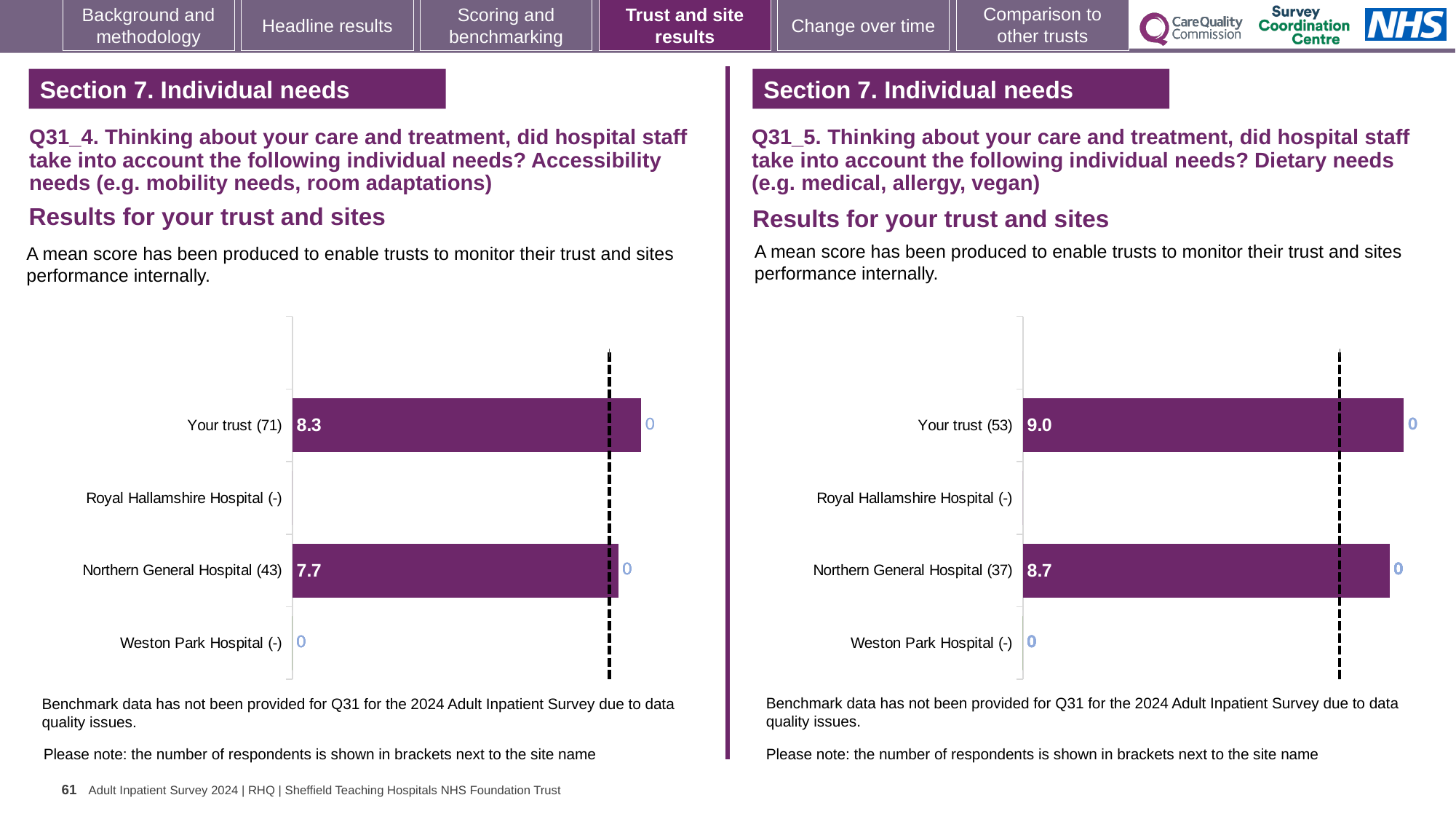
How many site categories are listed on the left chart (Q31_4, accessibility needs)? 4 On the right chart (Q31_5, dietary needs), what is the mean score for Northern General Hospital? 8.7 On the right chart (Q31_5, dietary needs), what is the difference between the mean score for Your trust and for Northern General Hospital? 0.3 On the right chart (Q31_5, dietary needs), what is the mean score for Your trust? 9.0 On the left chart (Q31_4, accessibility needs), which has the higher mean score: Your trust or Northern General Hospital? Your trust On the left chart (Q31_4, accessibility needs), which sites have no mean score shown (marked with a dash)? Royal Hallamshire Hospital and Weston Park Hospital On the left chart (Q31_4, accessibility needs), what is the mean score for Your trust? 8.3 On the left chart (Q31_4, accessibility needs), what is the difference between the mean score for Your trust and for Northern General Hospital? 0.6 Which is higher: the Your trust mean score on the left chart (Q31_4) or on the right chart (Q31_5)? Right chart (Q31_5), 9.0 What type of chart is used on the right (Q31_5, dietary needs)? Bar chart On the left chart (Q31_4, accessibility needs), what is the mean score for Northern General Hospital? 7.7 On the right chart (Q31_5, dietary needs), how many respondents are shown in brackets for Northern General Hospital? 37